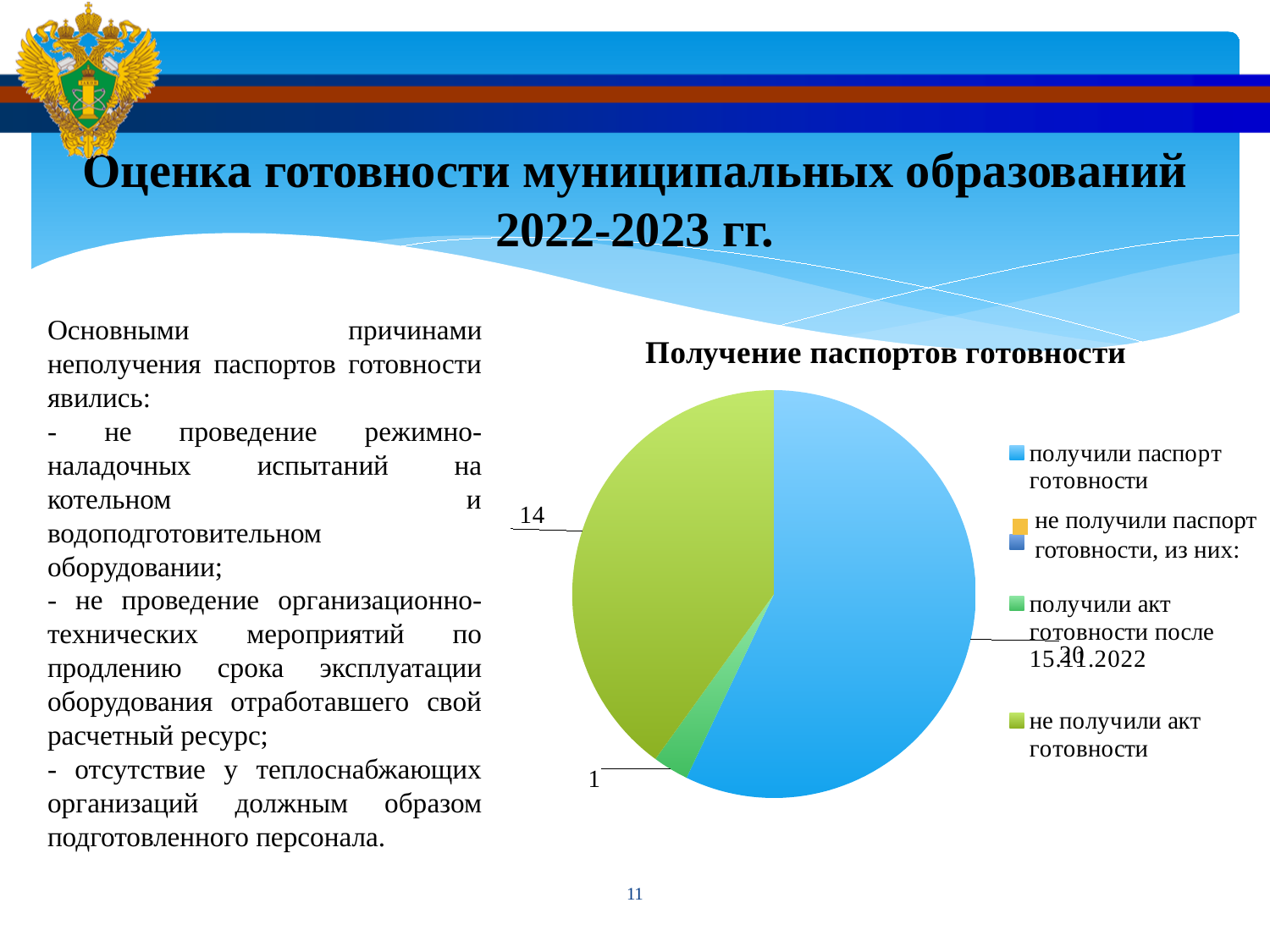
What is the value for "получили паспорт готовности"? 20 What is the value for "получили акт готовности после 15.11.2022"? 1 What colour is the largest slice of the pie? blue What is the difference between the values for "не получили акт готовности" and "получили акт готовности после 15.11.2022"? 13 What is the difference between the values for "получили паспорт готовности" and "не получили акт готовности"? 6 Which is larger: "получили паспорт готовности" or "не получили акт готовности"? получили паспорт готовности What kind of chart is shown on the slide? pie chart What is the title of the chart? Получение паспортов готовности Which category has the largest slice of the pie? получили паспорт готовности Which category has the smallest slice of the pie? получили акт готовности после 15.11.2022 How many entries does the legend list? 4 What is the value for "не получили акт готовности"? 14